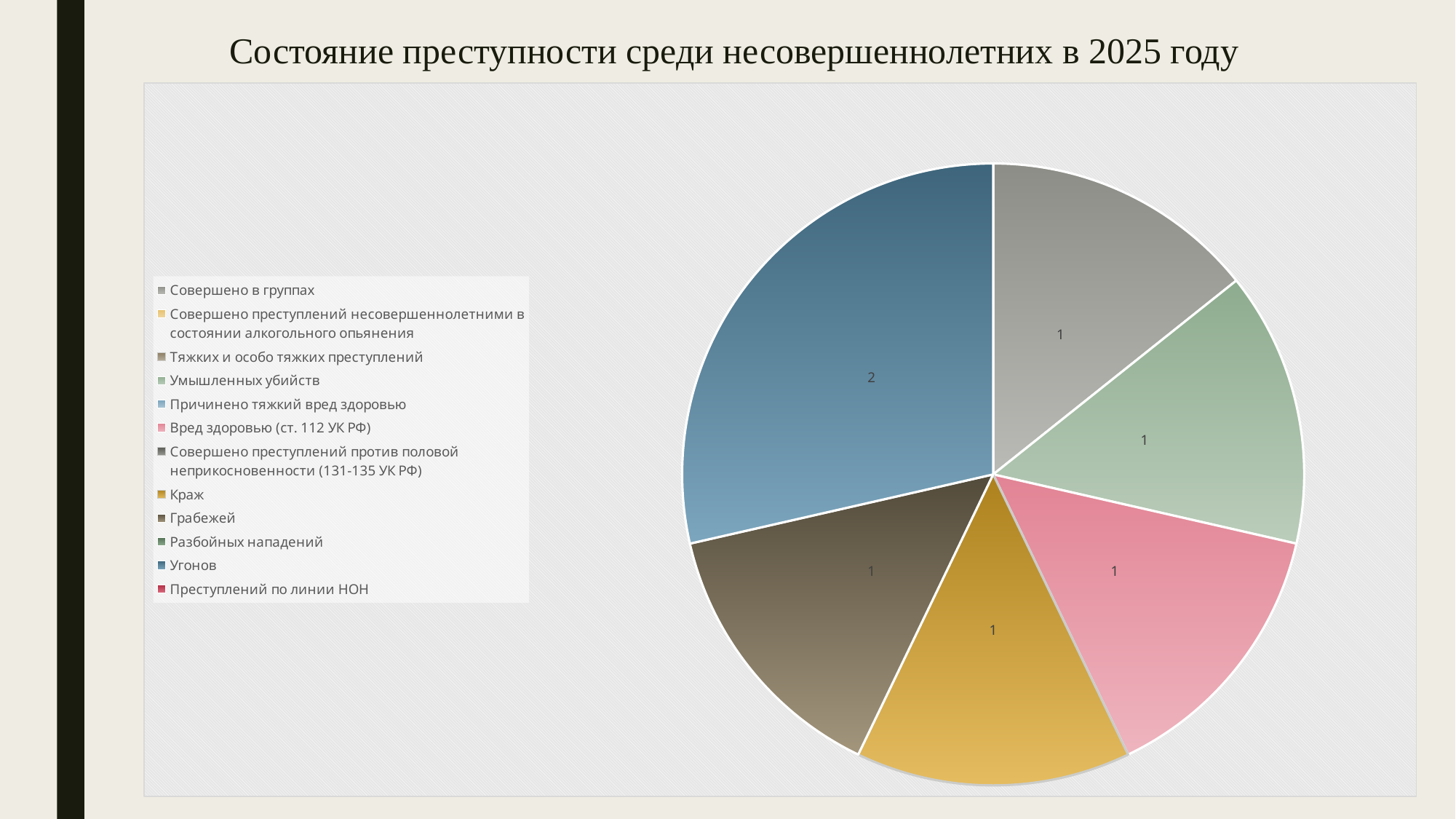
What is the value shown for Вред здоровью (ст. 112 УК РФ)? 1 How many slices with data labels are shown in the pie? 6 Is the legend placed to the left or to the right of the pie? left What is the value shown for Умышленных убийств? 1 How many slices are labeled with the value 1? 5 How many entries does the legend list? 12 What kind of chart is shown on the slide? pie chart What is the value shown for Совершено в группах? 1 What is the largest value labeled on any slice of the pie? 2 What is the total of all the values labeled on the pie slices? 7 What is the title of the chart? Состояние преступности среди несовершеннолетних в 2025 году What is the value shown for Краж? 1